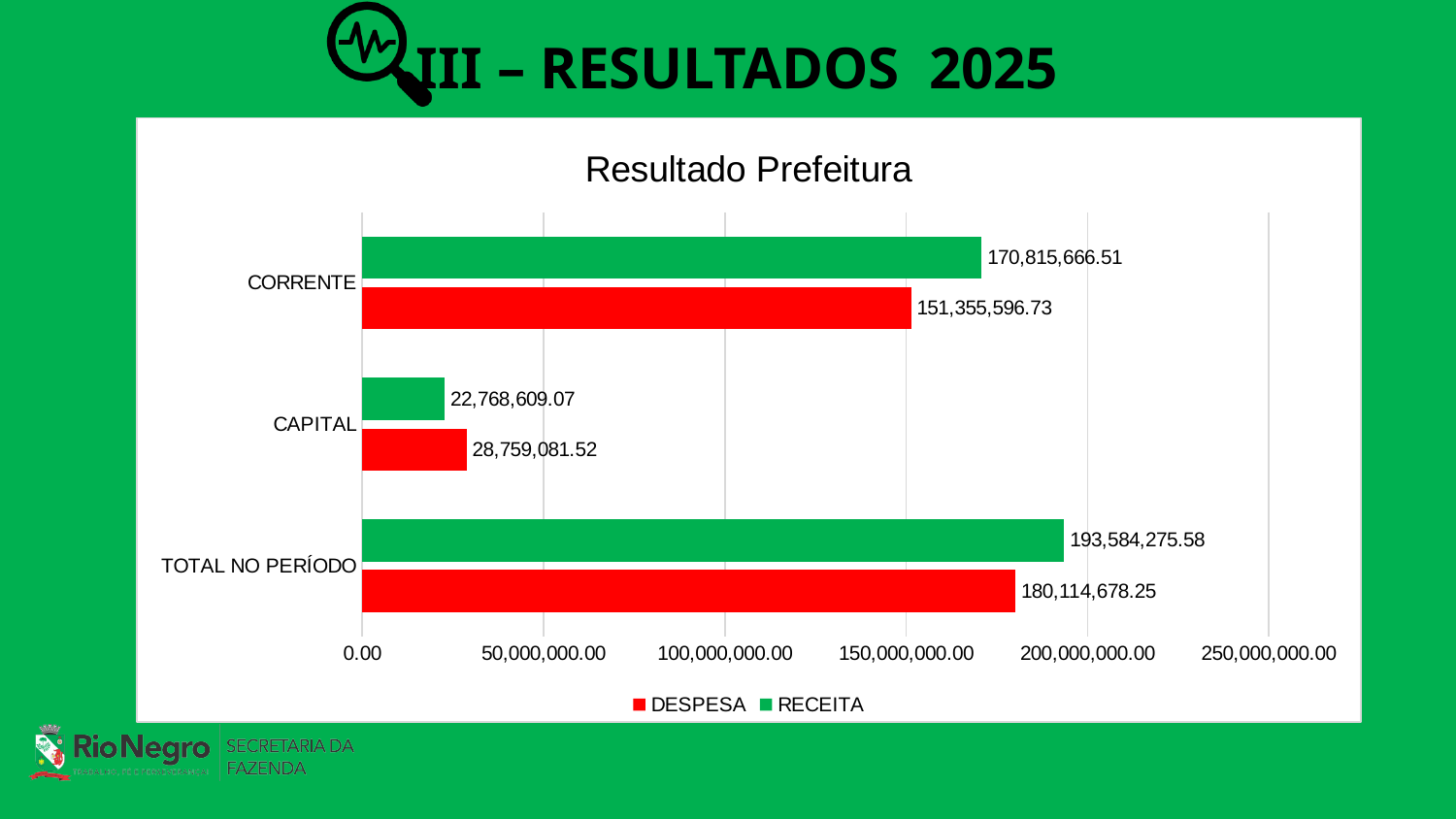
What is the difference between DESPESA and RECEITA for CAPITAL? 5,990,472.45 Is the DESPESA value for TOTAL NO PERÍODO greater or less than 200,000,000.00? less What is the RECEITA value for CORRENTE? 170,815,666.51 What is the RECEITA value for TOTAL NO PERÍODO? 193,584,275.58 What type of chart is shown? Bar chart How many series does the legend list? 2 For CAPITAL, which is larger, DESPESA or RECEITA? DESPESA What is the DESPESA value for CAPITAL? 28,759,081.52 Which category has the highest RECEITA value? TOTAL NO PERÍODO What is the DESPESA value for CORRENTE? 151,355,596.73 What is the difference between RECEITA and DESPESA for CORRENTE? 19,460,069.78 Which category has the lowest DESPESA value? CAPITAL